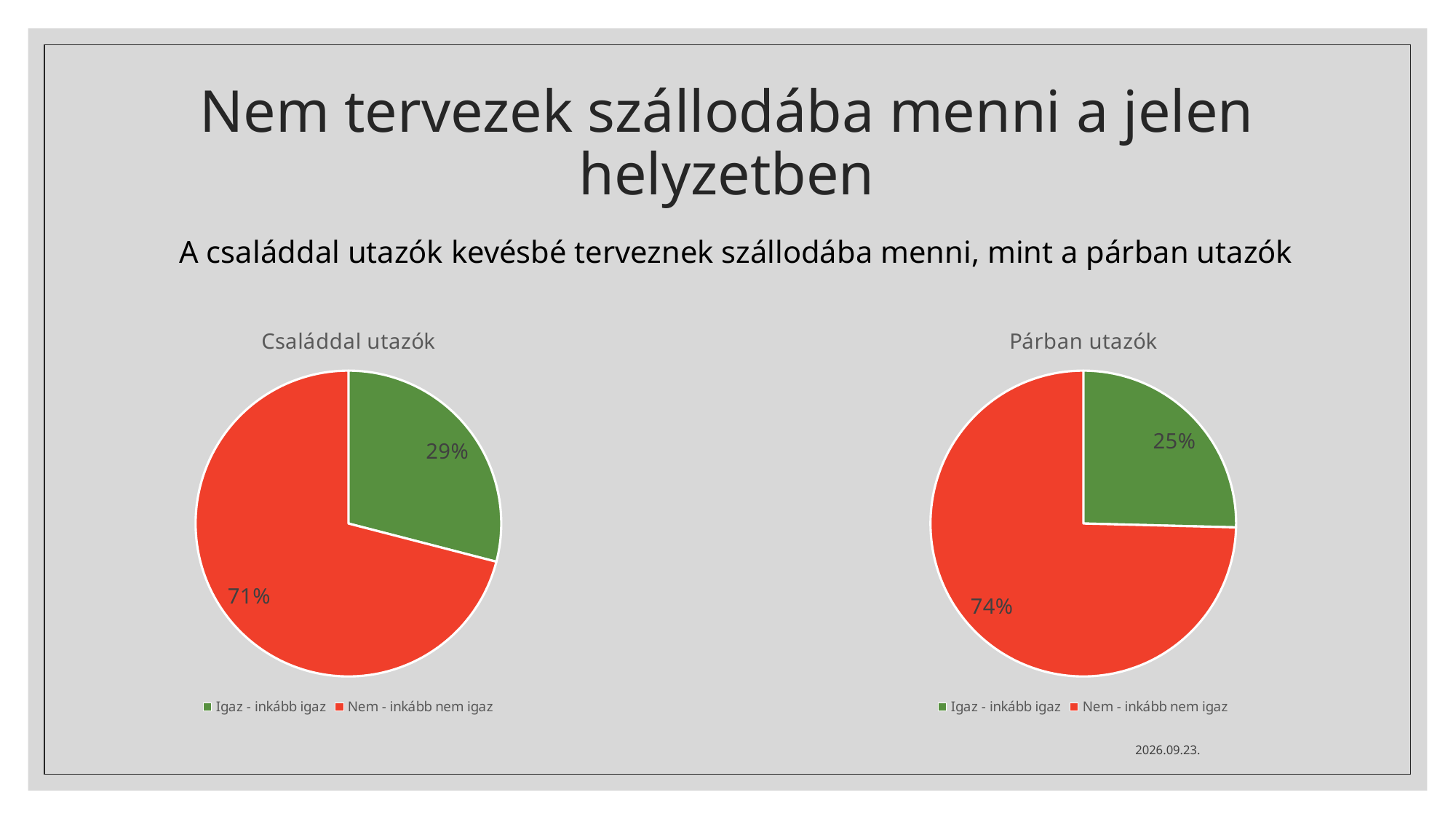
In the "Családdal utazók" chart, what share is labelled for "Nem - inkább nem igaz"? 71% In the "Családdal utazók" chart, what share is labelled for "Igaz - inkább igaz"? 29% Which chart shows a larger share for "Igaz - inkább igaz", "Családdal utazók" or "Párban utazók"? Családdal utazók In the "Családdal utazók" chart, what colour is the "Nem - inkább nem igaz" slice? Red In the "Családdal utazók" chart, which slice is the largest? Nem - inkább nem igaz How many entries does the legend of the "Párban utazók" chart list? 2 In the "Családdal utazók" chart, what is the difference between the "Nem - inkább nem igaz" and "Igaz - inkább igaz" shares? 42% In the "Párban utazók" chart, what share is labelled for "Igaz - inkább igaz"? 25% In the "Párban utazók" chart, what share is labelled for "Nem - inkább nem igaz"? 74% What kind of chart is the "Párban utazók" chart? Pie chart In the "Párban utazók" chart, which slice is the smallest? Igaz - inkább igaz How many slices does the "Családdal utazók" pie chart have? 2